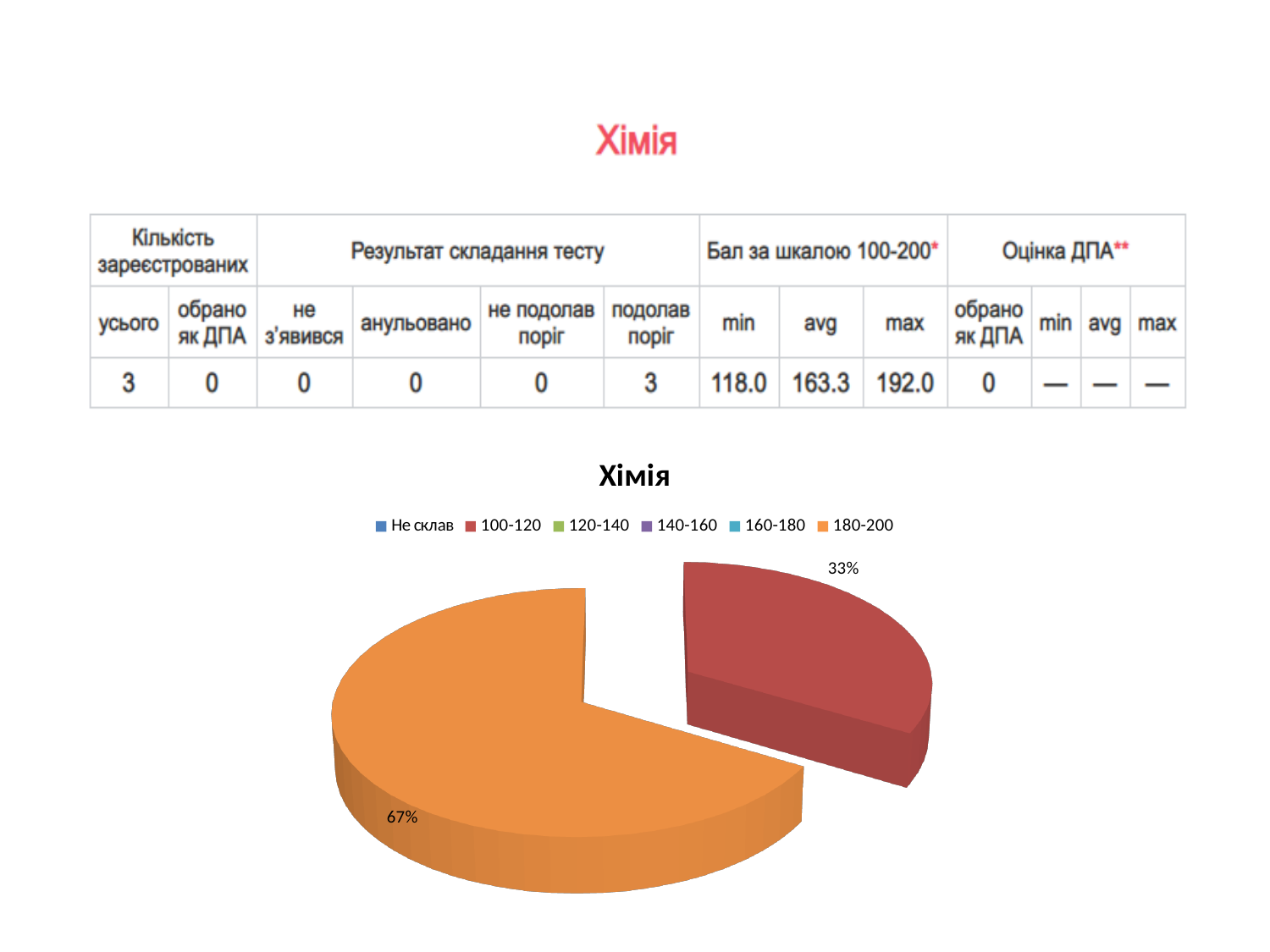
Is the share for 100-120 greater or less than 50%? less What share of the pie does the 180-200 slice represent? 67% What colour is the 180-200 slice? orange Which category has the largest slice of the pie? 180-200 How many entries does the chart legend list? 6 What kind of chart is shown on the slide? pie chart What share of the pie does the 100-120 slice represent? 33% What is the difference in percentage points between the 180-200 slice and the 100-120 slice? 34 Which of the two visible slices is larger, 100-120 or 180-200? 180-200 What is the title of the chart? Хімія How many slices are visible in the pie chart? 2